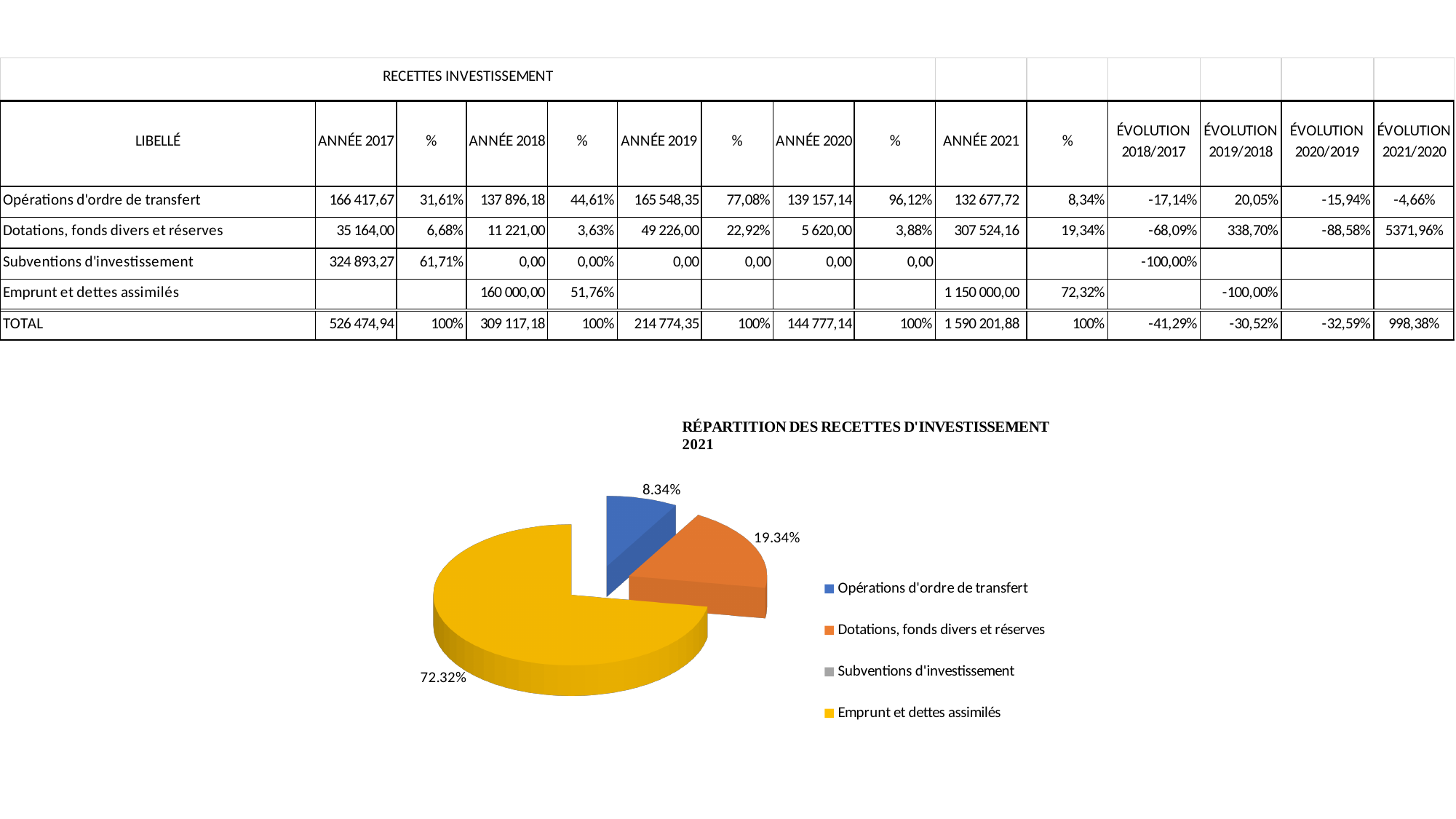
What is the title of the pie chart? RÉPARTITION DES RECETTES D'INVESTISSEMENT 2021 Among the slices with a visible label in the pie chart, which category has the smallest share? Opérations d'ordre de transfert In the pie chart, what share is shown for Emprunt et dettes assimilés? 72.32% What kind of chart is shown on the slide? Pie chart What colour is the slice for Emprunt et dettes assimilés in the pie chart? Yellow Which category has the largest slice in the pie chart? Emprunt et dettes assimilés What is the difference between the share for Emprunt et dettes assimilés and the share for Dotations, fonds divers et réserves in the pie chart? 52.98% In the pie chart, what share is shown for Opérations d'ordre de transfert? 8.34% What is the difference between the share for Dotations, fonds divers et réserves and the share for Opérations d'ordre de transfert in the pie chart? 11.00% How many entries does the pie chart's legend list? 4 In the pie chart, which is larger: the share for Dotations, fonds divers et réserves or the share for Opérations d'ordre de transfert? Dotations, fonds divers et réserves In the pie chart, what share is shown for Dotations, fonds divers et réserves? 19.34%